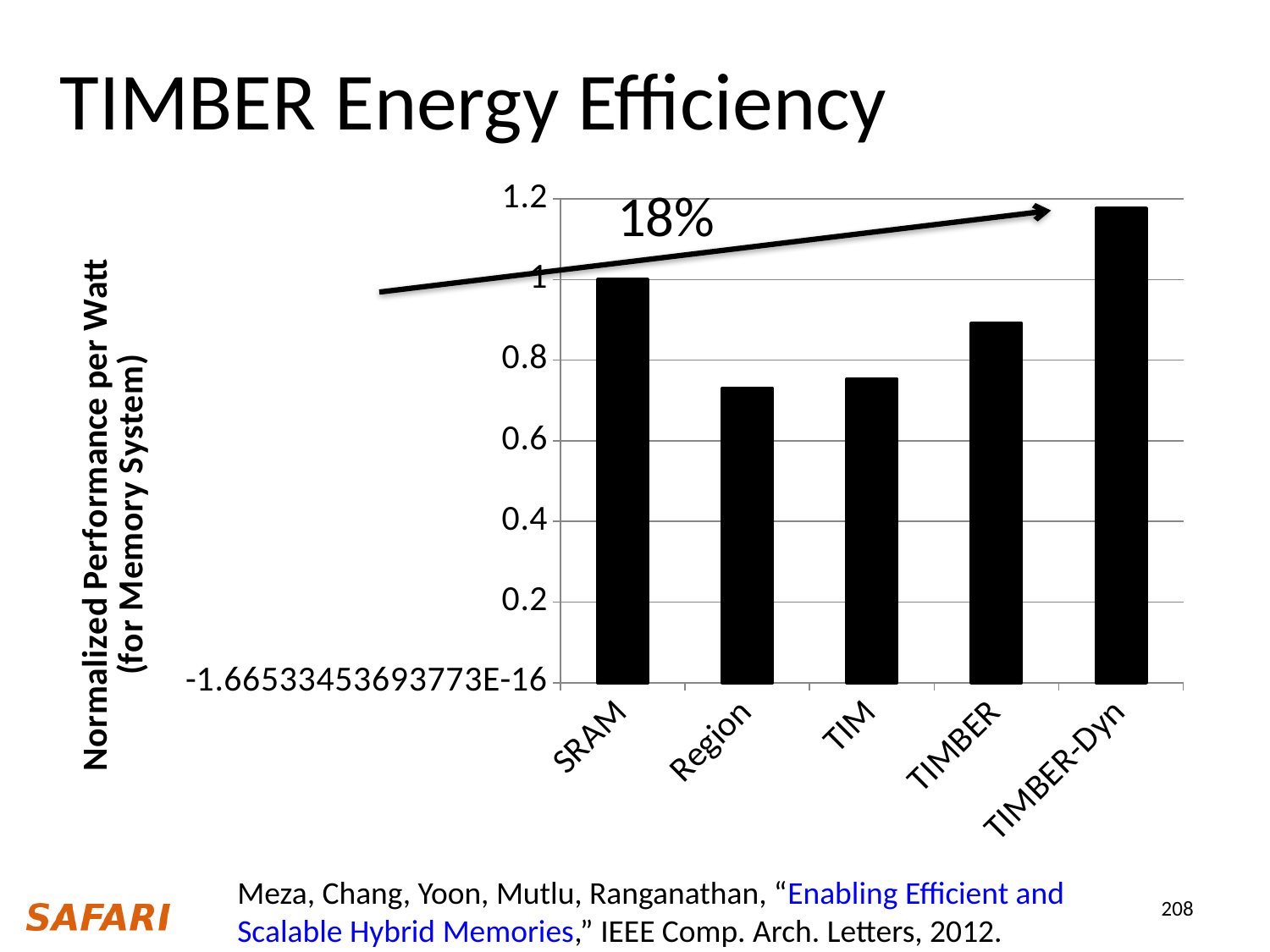
Which has a higher normalized performance per watt, SRAM or Region? SRAM What is the label of the y axis of the chart? Normalized Performance per Watt (for Memory System) Which has a higher normalized performance per watt, TIMBER or TIM? TIMBER What is the normalized performance per watt for SRAM? 1 Is the value for TIM greater or less than 0.8? less How many categories are plotted on the x axis of the chart? 5 Is the value for TIMBER greater or less than 0.8? greater Which category has the highest normalized performance per watt? TIMBER-Dyn Is the value for Region greater or less than 0.8? less What kind of chart is shown on the slide? bar chart What percentage is annotated next to the arrow on the chart? 18%